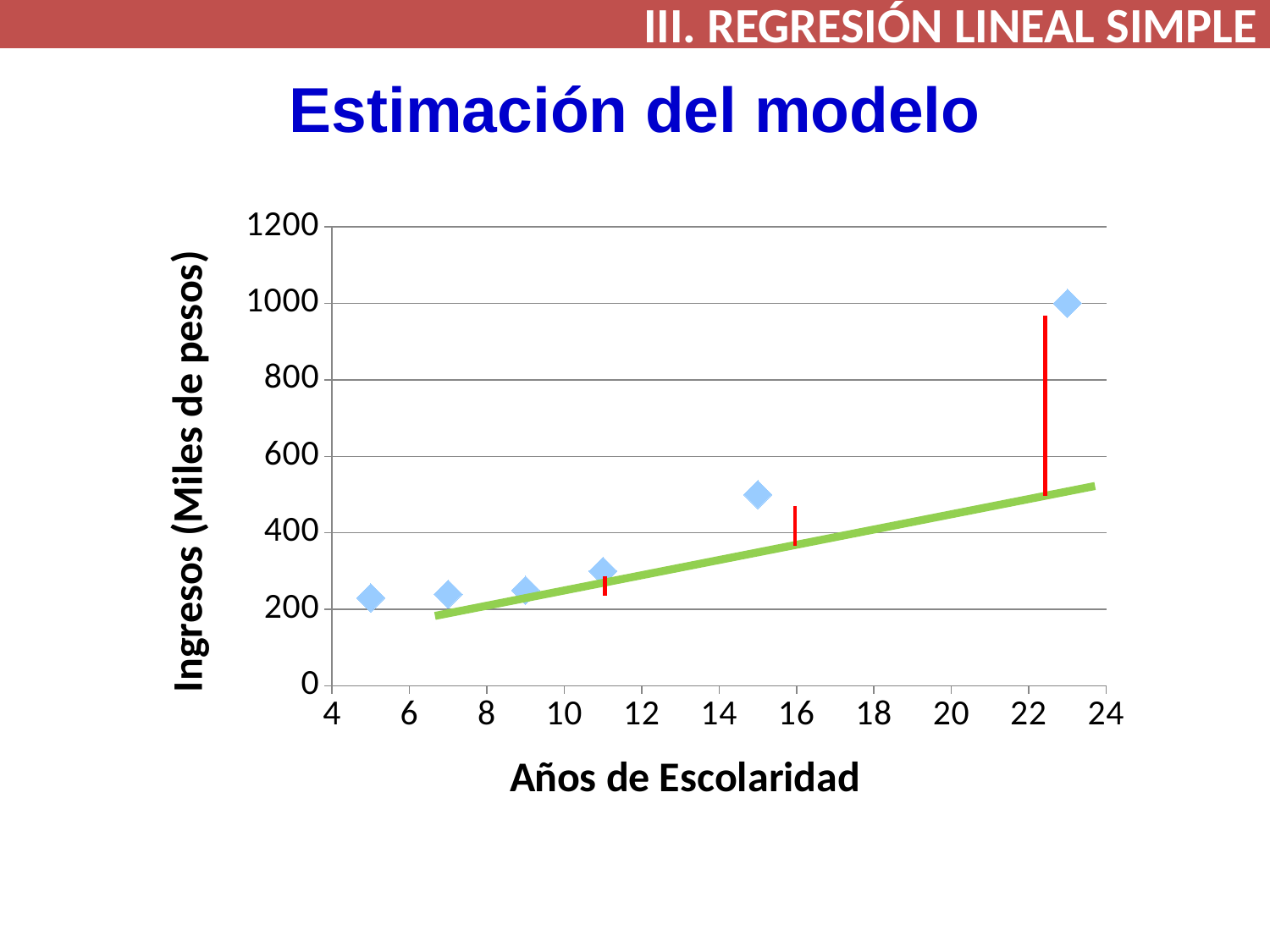
What is the title of the x axis? Años de Escolaridad What is the title of the y axis? Ingresos (Miles de pesos) At which number of years of schooling is the plotted income lowest? 5 Do the plotted income values rise or fall as years of schooling increase? Rise What kind of chart is shown on the slide? Scatter plot Is the income value for the point at 5 years of schooling greater or less than 400? less How many data points (diamond markers) are plotted on the chart? 6 Is the income value for the point at 23 years of schooling greater or less than 800? greater Is the income value for the point at 11 years of schooling greater or less than 400? less At which number of years of schooling is the plotted income highest? 23 Which point has the highest income value: the one at 23 years of schooling or the one at 15 years? 23 years